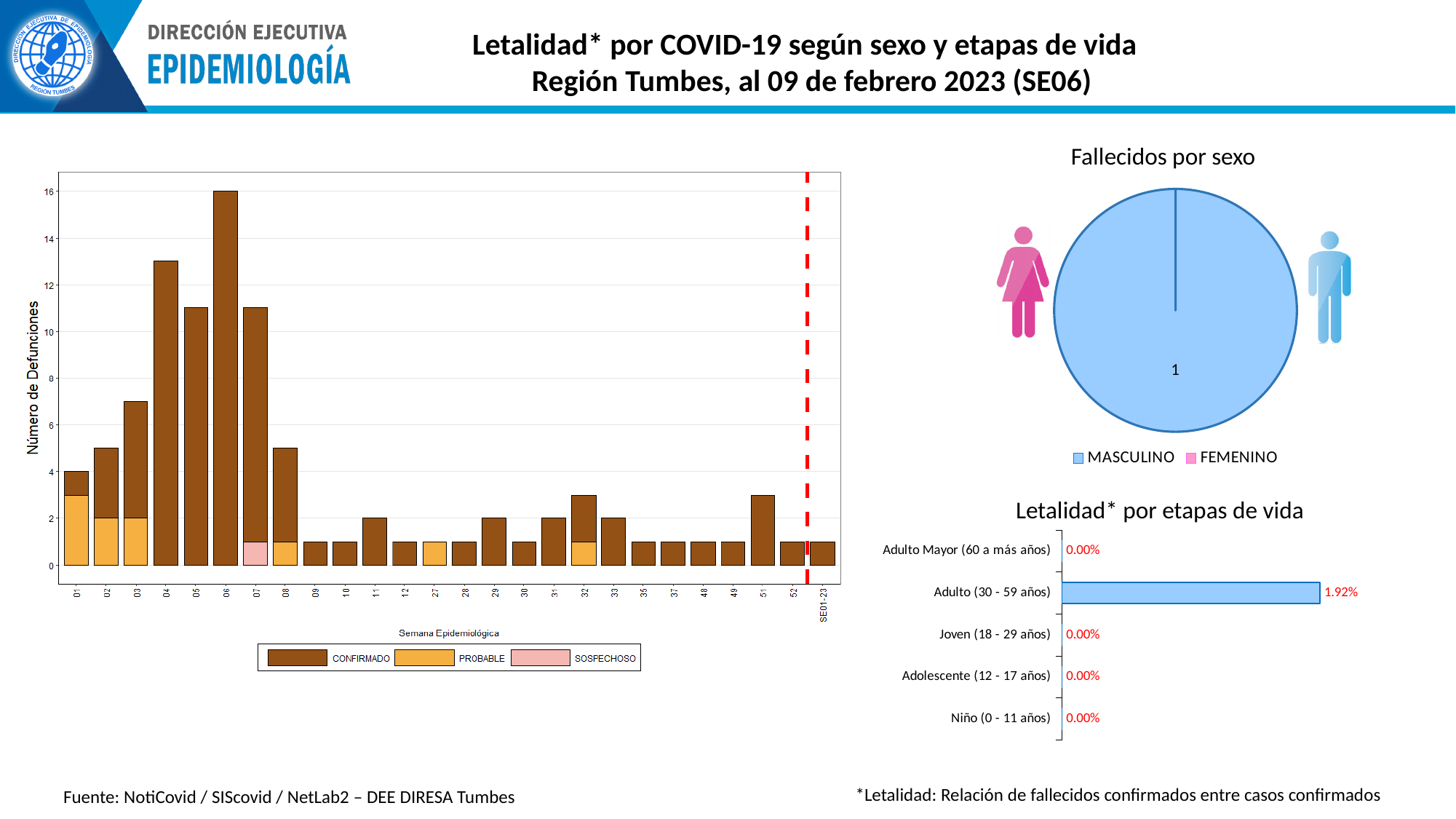
In the 'Fallecidos por sexo' chart, what value is printed on the pie? 1 In the chart on the left (Número de Defunciones by Semana Epidemiológica), how many series does the legend list? 3 In the chart on the left (Número de Defunciones by Semana Epidemiológica), is the value for week 04 greater or less than 12? greater In the 'Fallecidos por sexo' chart, how many entries does the legend list? 2 In the 'Letalidad* por etapas de vida' chart, what is the difference between the value for Adulto (30 - 59 años) and the value for Joven (18 - 29 años)? 1.92% In the chart on the left (Número de Defunciones by Semana Epidemiológica), what is the number of deaths in week 06? 16 In the 'Letalidad* por etapas de vida' chart, which age group has the highest lethality? Adulto (30 - 59 años) In the chart on the left (Número de Defunciones by Semana Epidemiológica), is the value for week 03 greater or less than 6? greater In the chart on the left (Número de Defunciones by Semana Epidemiológica), which is larger, the value for week 05 or the value for week 08? week 05 In the 'Letalidad* por etapas de vida' chart, what is the value for Adulto (30 - 59 años)? 1.92% In the chart on the left (Número de Defunciones by Semana Epidemiológica), which epidemiological week has the highest number of deaths? 06 In the 'Letalidad* por etapas de vida' chart, how many age groups are shown? 5